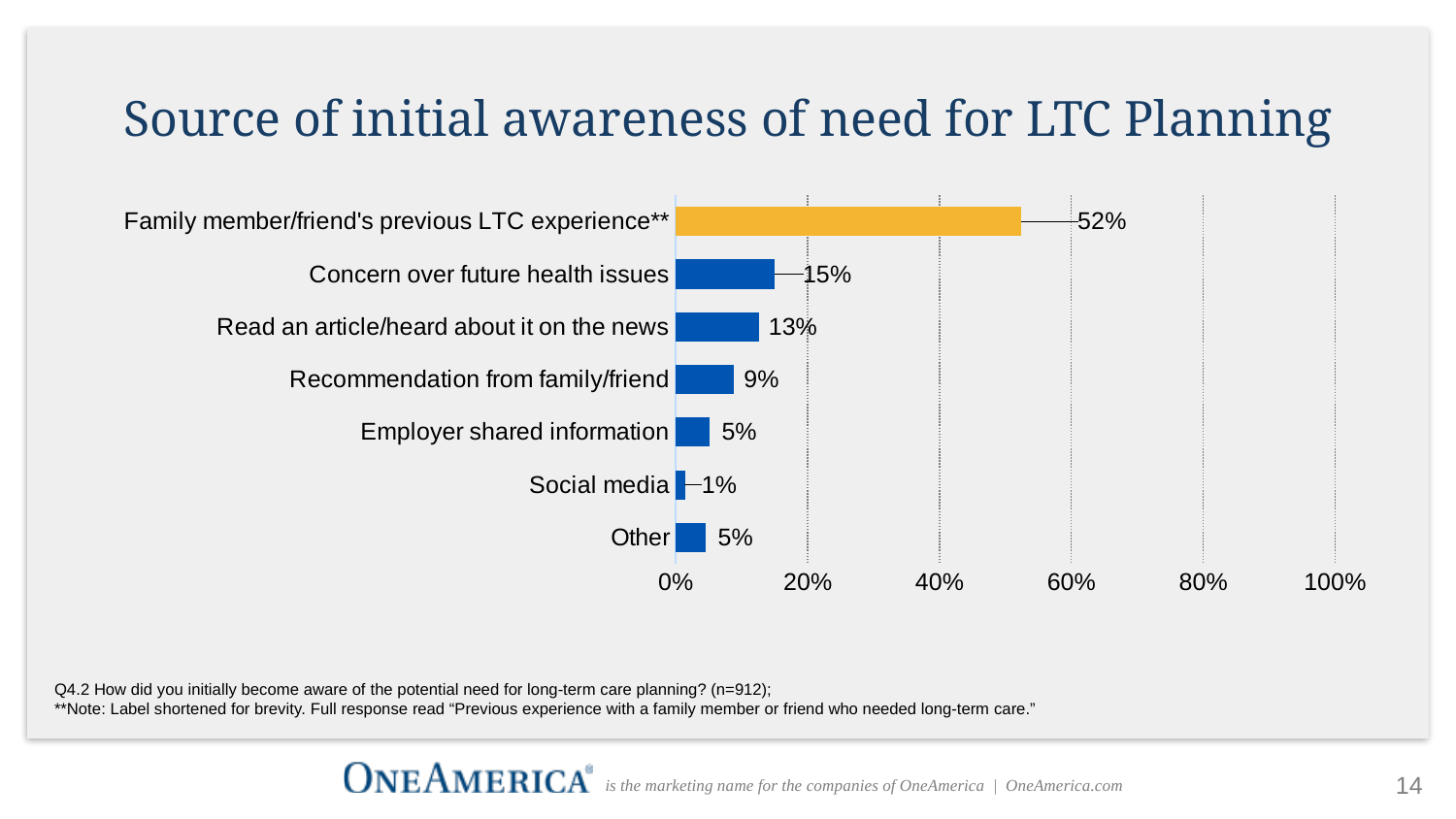
What is the value for 'Social media'? 1% What is the difference between 'Recommendation from family/friend' and 'Employer shared information'? 4% Which is larger: 'Concern over future health issues' or 'Read an article/heard about it on the news'? Concern over future health issues What is the value for 'Concern over future health issues'? 15% Which category has the highest value? Family member/friend's previous LTC experience** What percentage is shown for 'Read an article/heard about it on the news'? 13% What percentage of respondents cited a family member/friend's previous LTC experience as their source of initial awareness? 52% Which category has the lowest value? Social media What is the difference between 'Family member/friend's previous LTC experience' and 'Concern over future health issues'? 37% What is the title of the chart? Source of initial awareness of need for LTC Planning How many categories are shown in the chart? 7 What type of chart is shown on the slide? Bar chart